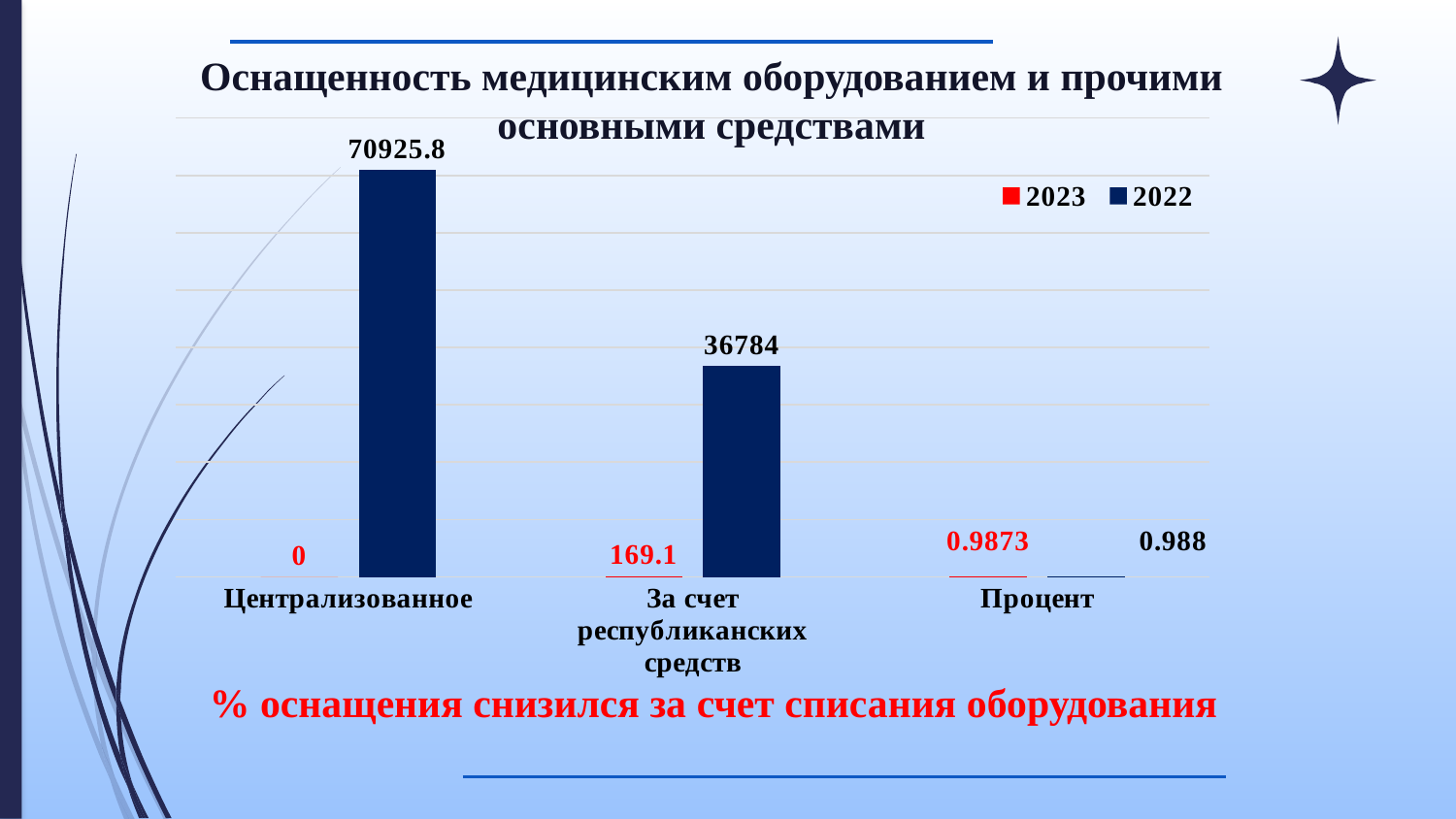
Which category has the highest 2022 value? Централизованное Which is larger for За счет республиканских средств: the 2022 value or the 2023 value? 2022 What is the 2023 value for За счет республиканских средств? 169.1 What is the 2022 value for Процент? 0.988 What is the 2022 value for За счет республиканских средств? 36784 What is the 2022 value for Централизованное? 70925.8 How many series does the legend list? 2 What is the difference between the 2022 values for Централизованное and За счет республиканских средств? 34141.8 What is the 2023 value for Централизованное? 0 Which category has the lowest 2023 value? Централизованное What is the 2023 value for Процент? 0.9873 What type of chart is shown on the slide? Bar chart